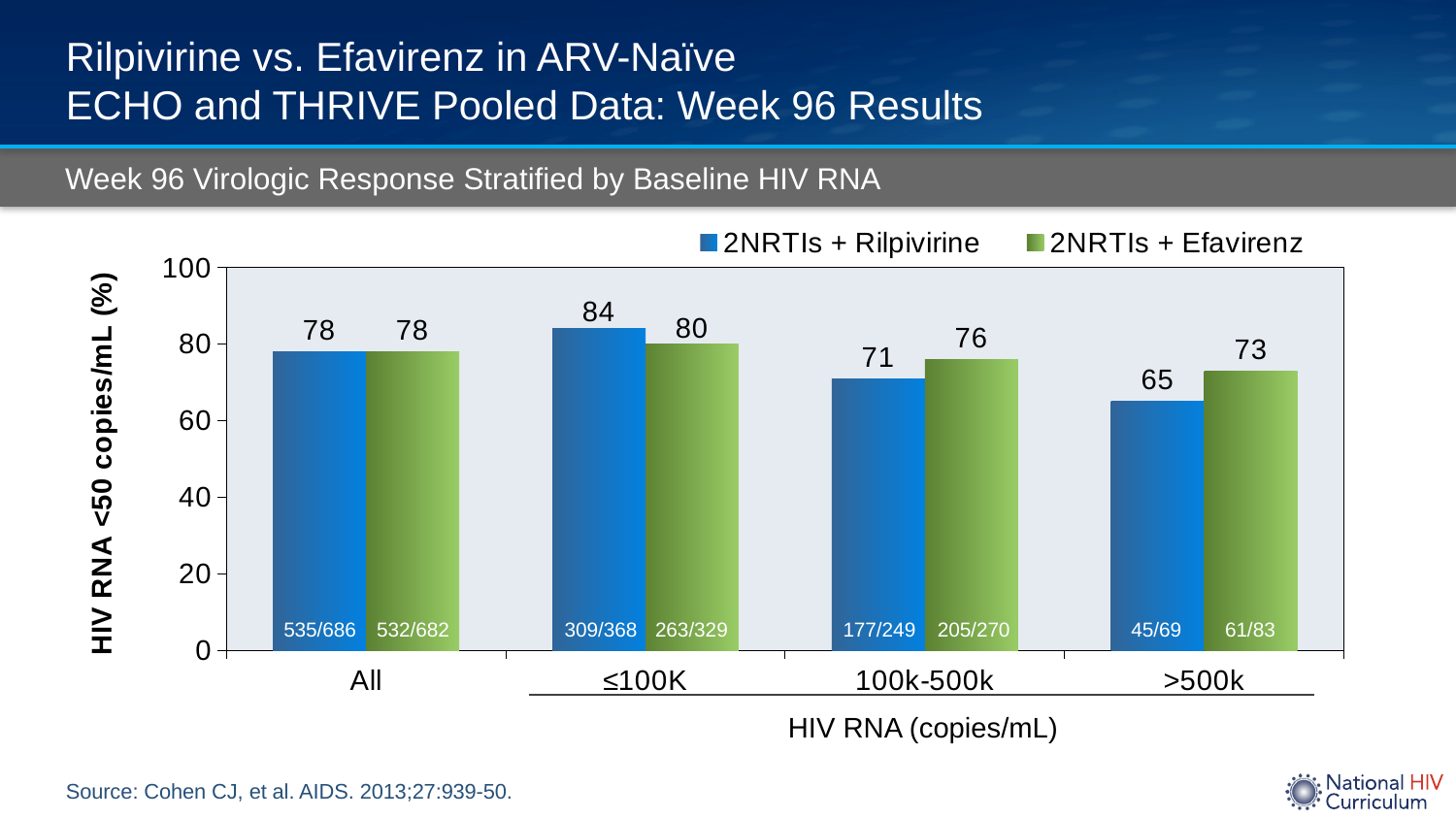
What is the fraction label shown inside the 2NRTIs + Rilpivirine bar for the All category? 535/686 What is the y-axis label of the chart? HIV RNA <50 copies/mL (%) How many baseline HIV RNA categories are shown on the x axis? 4 Which category has the highest value for 2NRTIs + Rilpivirine? ≤100K What is the difference between the 2NRTIs + Efavirenz and 2NRTIs + Rilpivirine values in the >500k category? 8 Which category has the lowest value for 2NRTIs + Efavirenz? >500k How many series does the legend list? 2 In the 100k-500k category, which series has the larger value, 2NRTIs + Rilpivirine or 2NRTIs + Efavirenz? 2NRTIs + Efavirenz What kind of chart is shown on the slide? Bar chart What is the value for 2NRTIs + Efavirenz in the >500k category? 73 What is the value for 2NRTIs + Rilpivirine in the ≤100K category? 84 What is the value for 2NRTIs + Rilpivirine in the 100k-500k category? 71